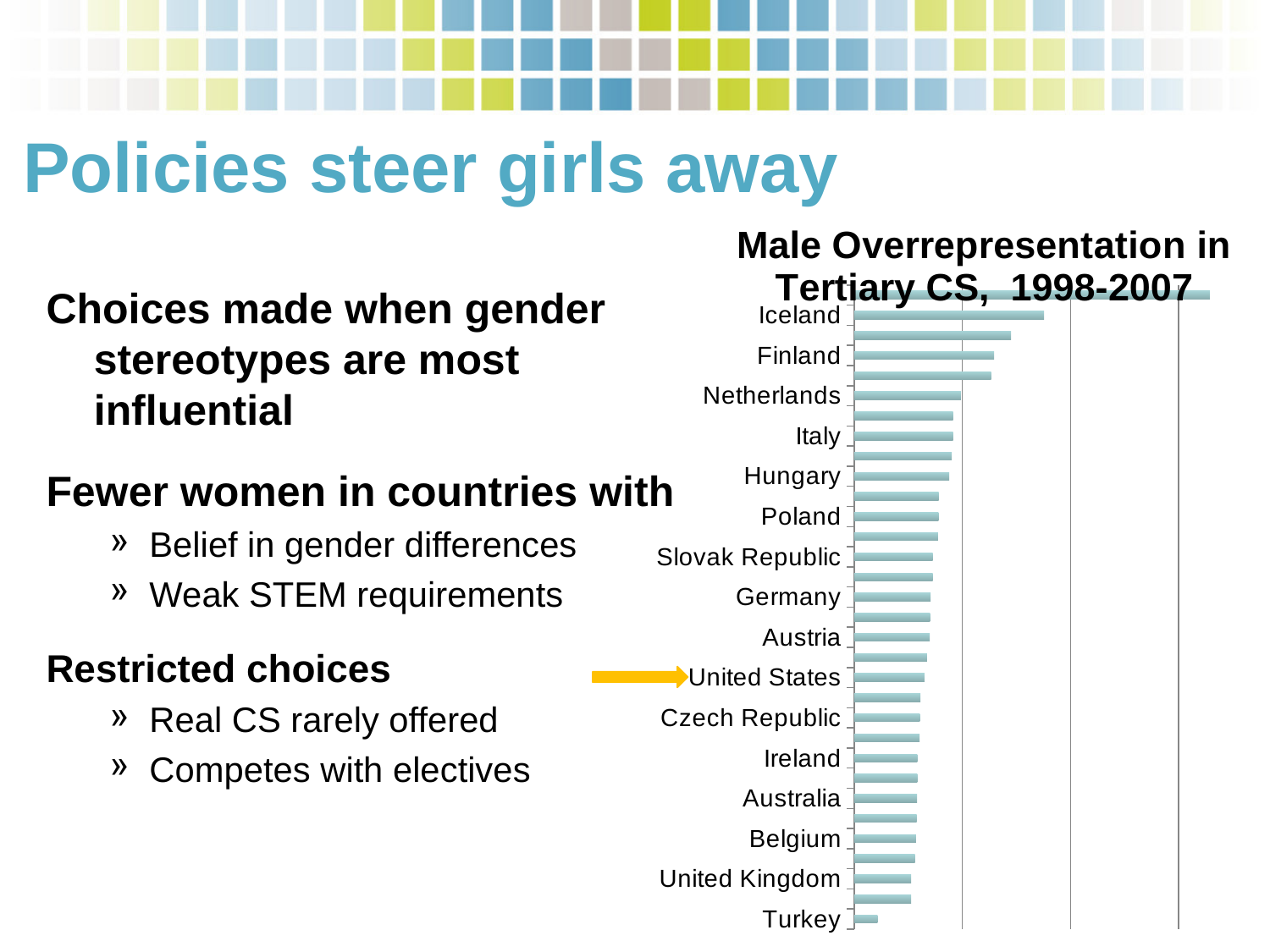
Which country's bar is longer, Turkey or Ireland? Ireland Which country's bar is longer, Hungary or Australia? Hungary Which labelled country has the shortest bar in the chart? Turkey Which country on the chart is marked with an orange arrow? United States Which country's bar is longer, Netherlands or Belgium? Netherlands What is the title of the chart on the slide? Male Overrepresentation in Tertiary CS, 1998-2007 What kind of chart is shown on the slide? bar chart Do the bar lengths increase or decrease going from the top of the chart to the bottom? decrease